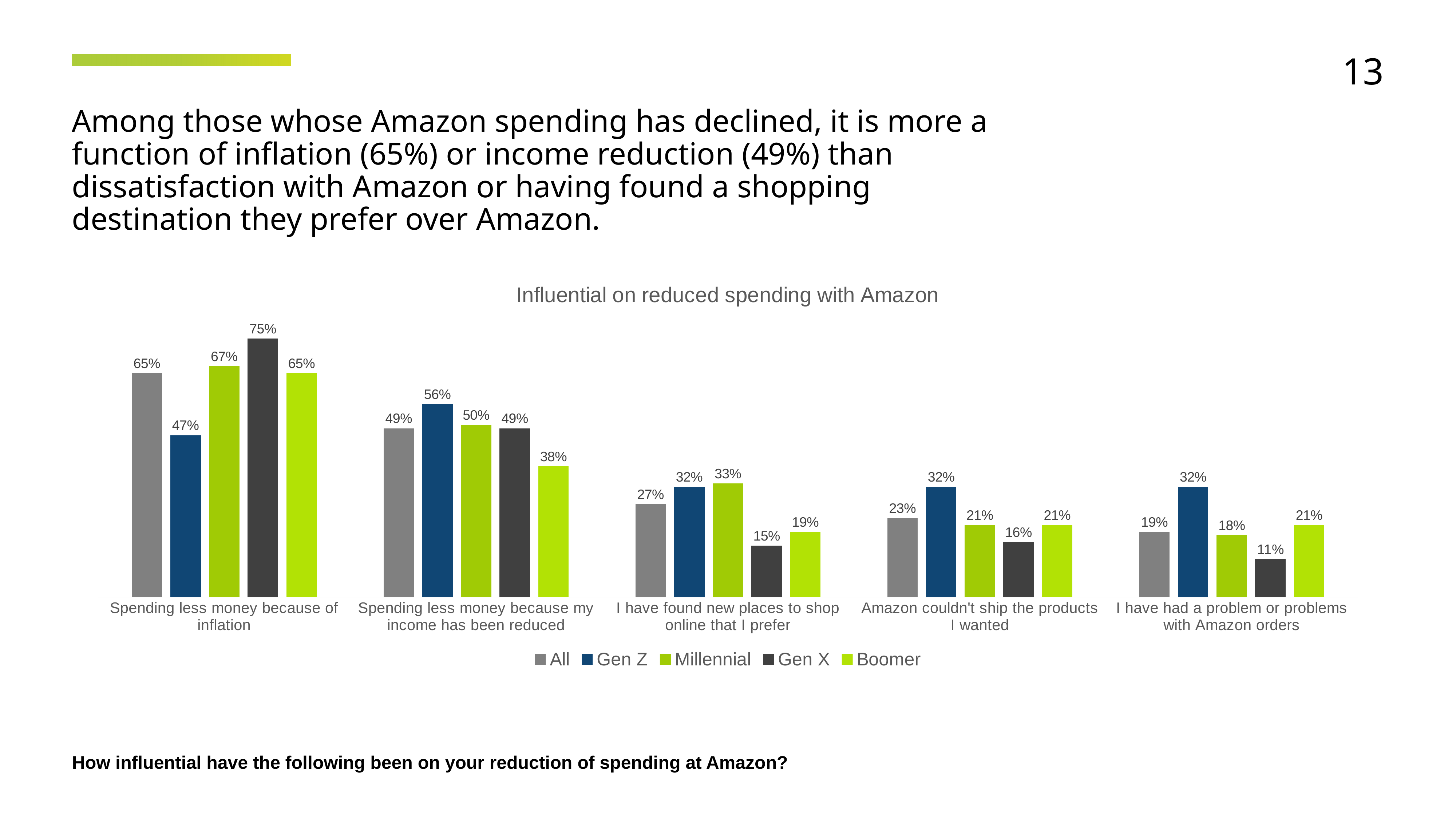
How many series does the legend list? 5 Which series has the lowest value for "Amazon couldn't ship the products I wanted"? Gen X What is the Gen X value for "I have had a problem or problems with Amazon orders"? 11% Which is larger for "Spending less money because my income has been reduced": Gen Z or Boomer? Gen Z What is the difference between the Gen Z and Gen X values for "Spending less money because of inflation"? 28% What is the Boomer value for "Spending less money because my income has been reduced"? 38% What is the All value for "I have found new places to shop online that I prefer"? 27% What is the title of the chart? Influential on reduced spending with Amazon Which series has the highest value for "Spending less money because of inflation"? Gen X What is the Gen X value for "Spending less money because of inflation"? 75% How many categories are shown on the x axis? 5 What kind of chart is shown on the slide? Bar chart